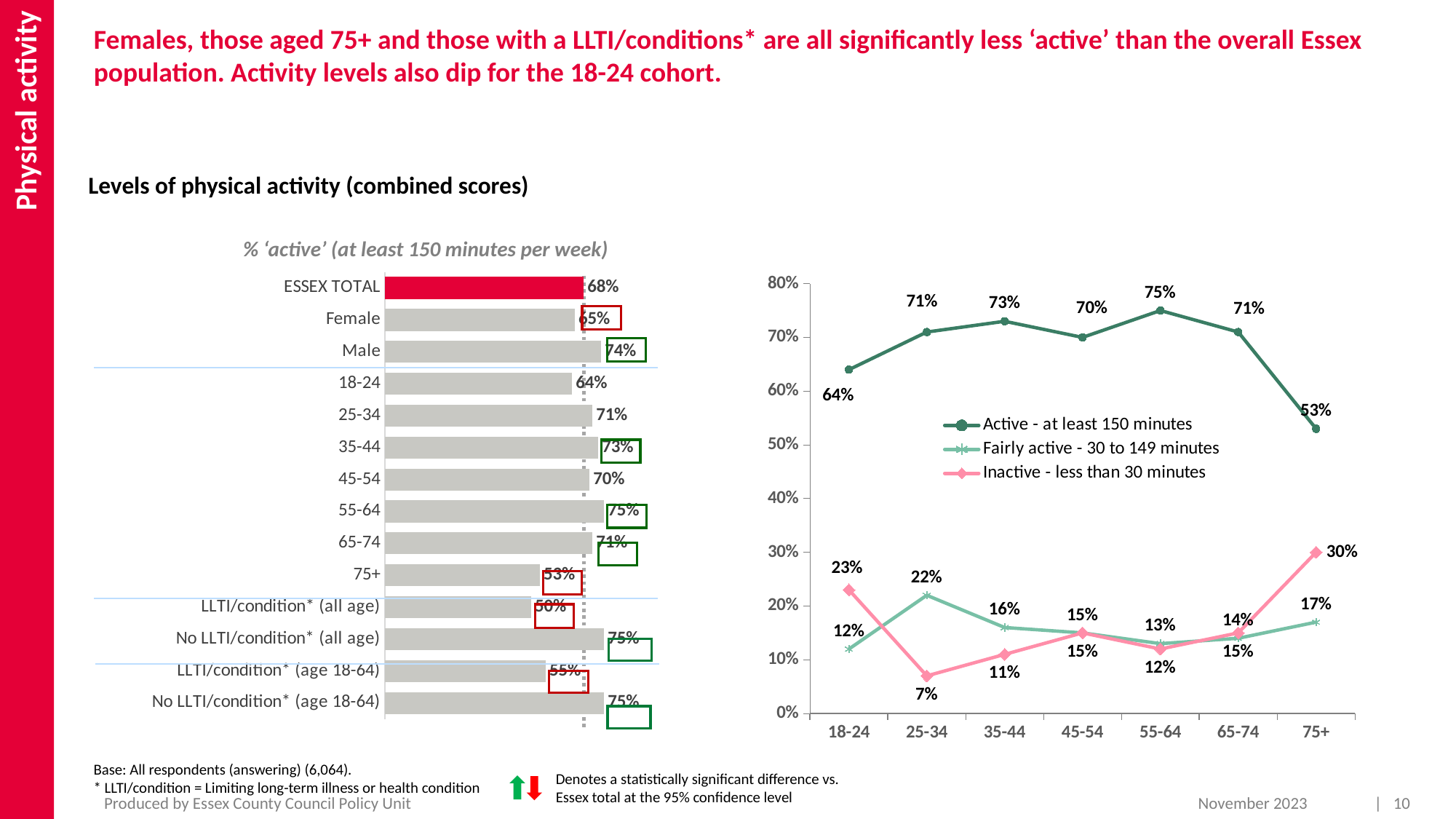
In the line chart on the right, which age group has the highest value for 'Active - at least 150 minutes'? 55-64 In the bar chart '% active (at least 150 minutes per week)', what is the value for Male? 74% In the line chart on the right, how many age groups are shown on the x axis? 7 In the line chart on the right, does the 'Inactive - less than 30 minutes' series rise or fall between 65-74 and 75+? Rise What kind of chart is the chart on the left of the slide? Bar chart In the bar chart '% active (at least 150 minutes per week)', what is the value for ESSEX TOTAL? 68% In the bar chart '% active (at least 150 minutes per week)', which age group has the lowest value? 75+ In the line chart on the right, what is the value of 'Fairly active - 30 to 149 minutes' for the 25-34 age group? 22% In the line chart on the right, what is the value of 'Inactive - less than 30 minutes' for the 75+ age group? 30% In the bar chart '% active (at least 150 minutes per week)', what is the difference between Male and Female? 9% How many series does the legend of the line chart on the right list? 3 In the bar chart '% active (at least 150 minutes per week)', which is larger, the value for 18-24 or the value for 25-34? 25-34